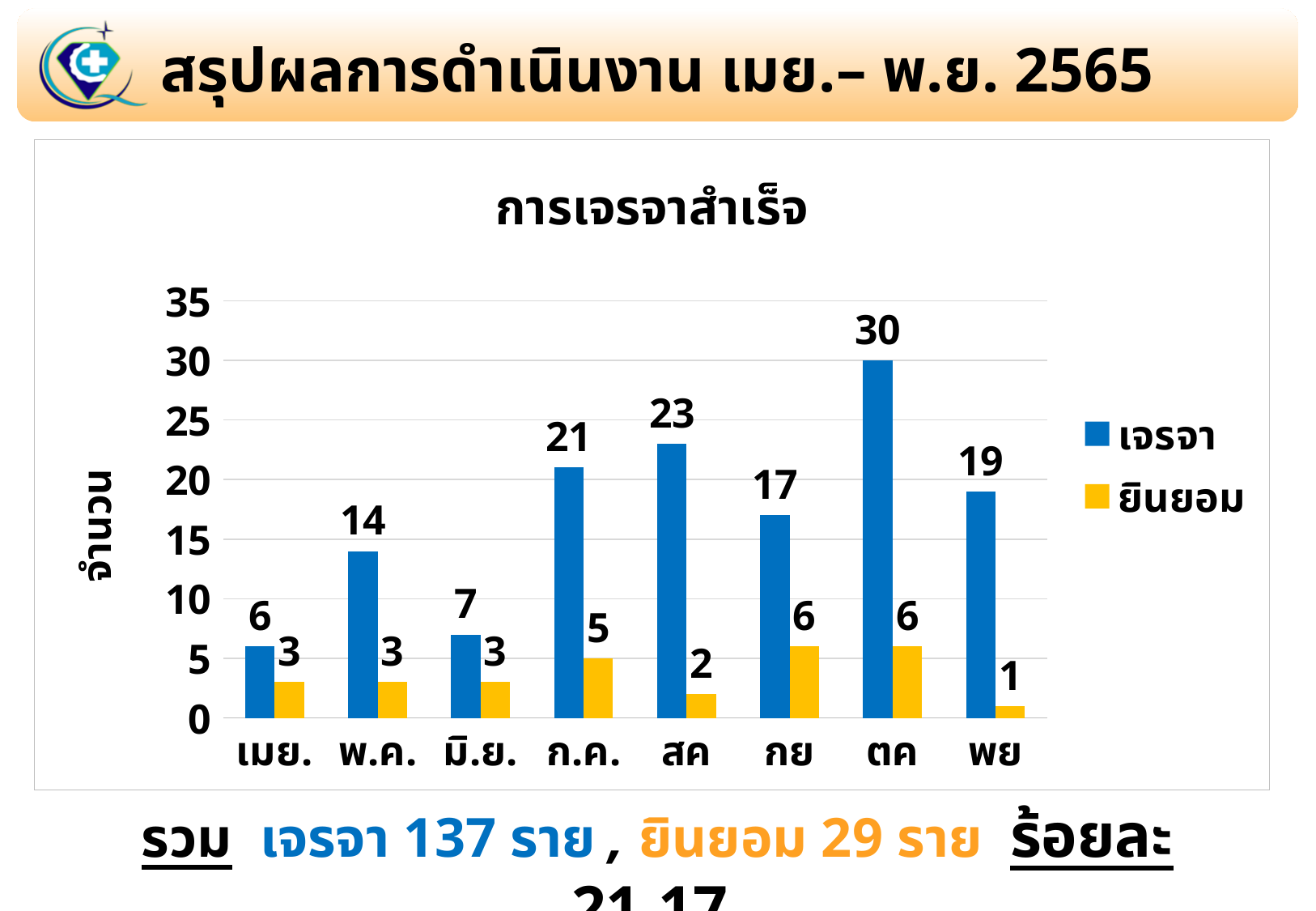
What is the value of เจรจา for พ.ค.? 14 How many series does the legend list? 2 Which month has the lowest ยินยอม value? พย What is the value of ยินยอม for ก.ค.? 5 What is the difference between the เจรจา and ยินยอม values for สค? 21 What is the value of เจรจา for ตค? 30 What is the title of the chart? การเจรจาสำเร็จ Which colour represents the ยินยอม series? yellow Which is larger, the เจรจา value for ก.ค. or the เจรจา value for พย? ก.ค. How many months are shown on the x axis? 8 Which month has the highest เจรจา value? ตค What kind of chart is shown? bar chart